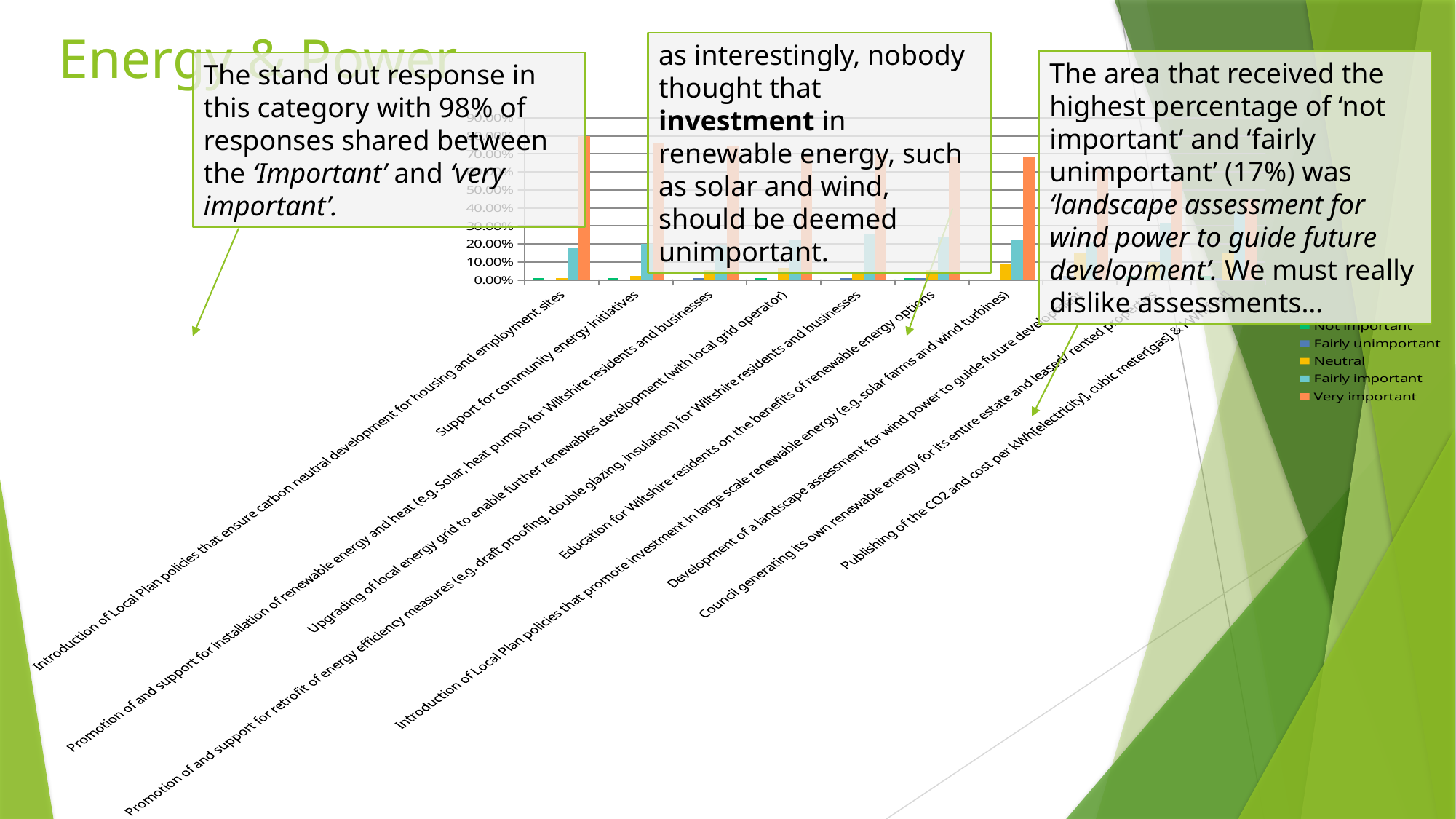
Is the 'Very important' value for 'Introduction of Local Plan policies that ensure carbon neutral development for housing and employment sites' greater or less than 50.00%? greater Which series is shown in yellow in the chart legend? Neutral Is the 'Very important' value for 'Development of a landscape assessment for wind power to guide future development' greater or less than 50.00%? greater For 'Development of a landscape assessment for wind power to guide future development', which is larger: the 'Very important' value or the 'Fairly important' value? Very important How many series does the chart legend list? 5 Which series is shown in orange in the chart legend? Very important For 'Introduction of Local Plan policies that ensure carbon neutral development for housing and employment sites', which is larger: the 'Fairly important' value or the 'Neutral' value? Fairly important How many categories are shown along the x axis of the chart? 10 For 'Introduction of Local Plan policies that ensure carbon neutral development for housing and employment sites', which series has the highest value? Very important What kind of chart is shown on the slide? bar chart Is the 'Fairly important' value for 'Development of a landscape assessment for wind power to guide future development' greater or less than 10.00%? greater